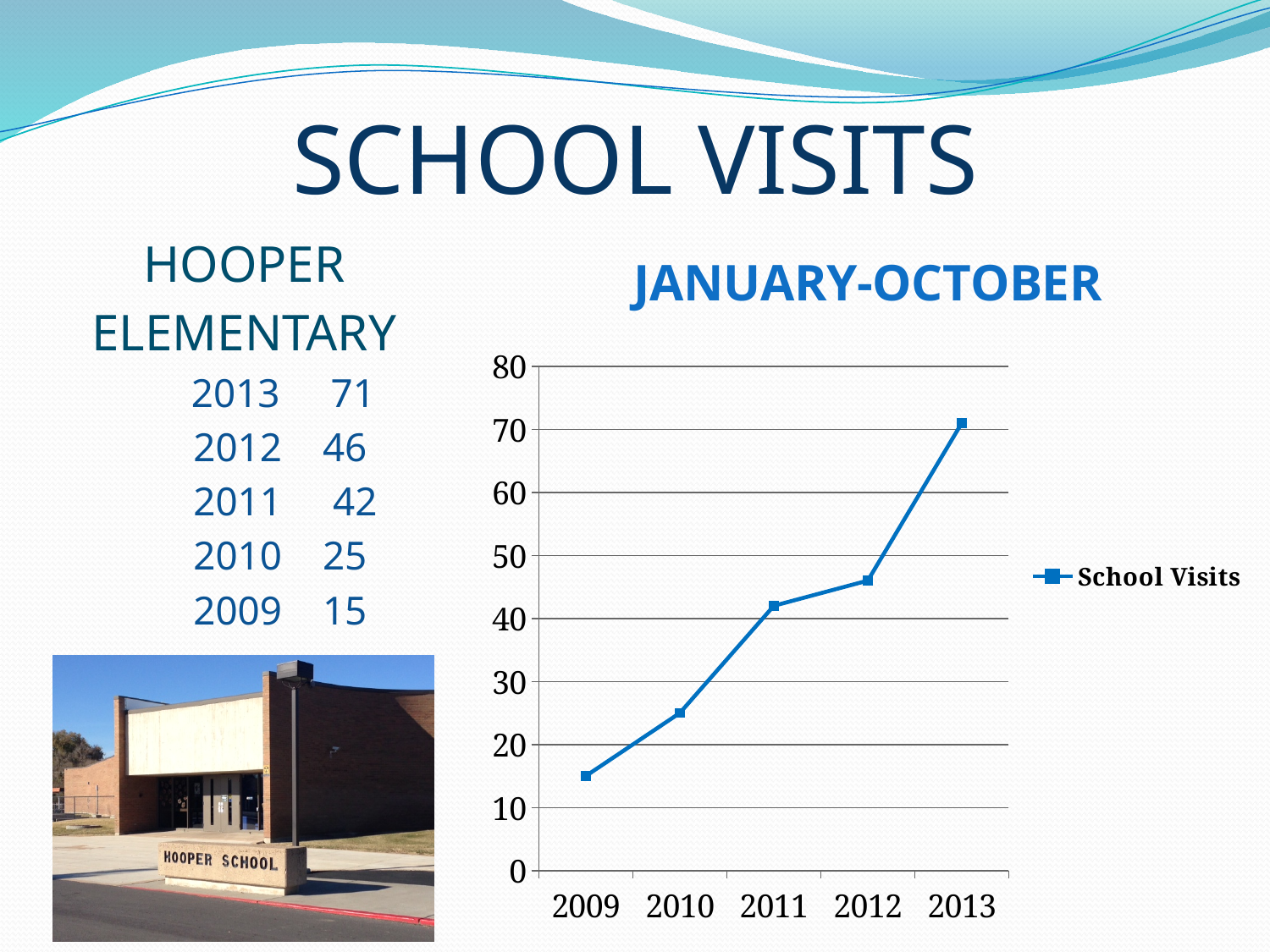
What is the name of the series shown in the chart legend? School Visits What is the number of school visits for 2009? 15 Do school visits rise or fall from 2009 to 2013? rise How many years are plotted on the x axis of the chart? 5 Which year has the lowest number of school visits? 2009 What is the number of school visits for 2013? 71 How many series does the chart legend list? 1 Which year has the highest number of school visits? 2013 What is the number of school visits for 2011? 42 What type of chart is shown on the slide? line chart What is the difference in school visits between 2013 and 2012? 25 Which year had more school visits, 2010 or 2012? 2012